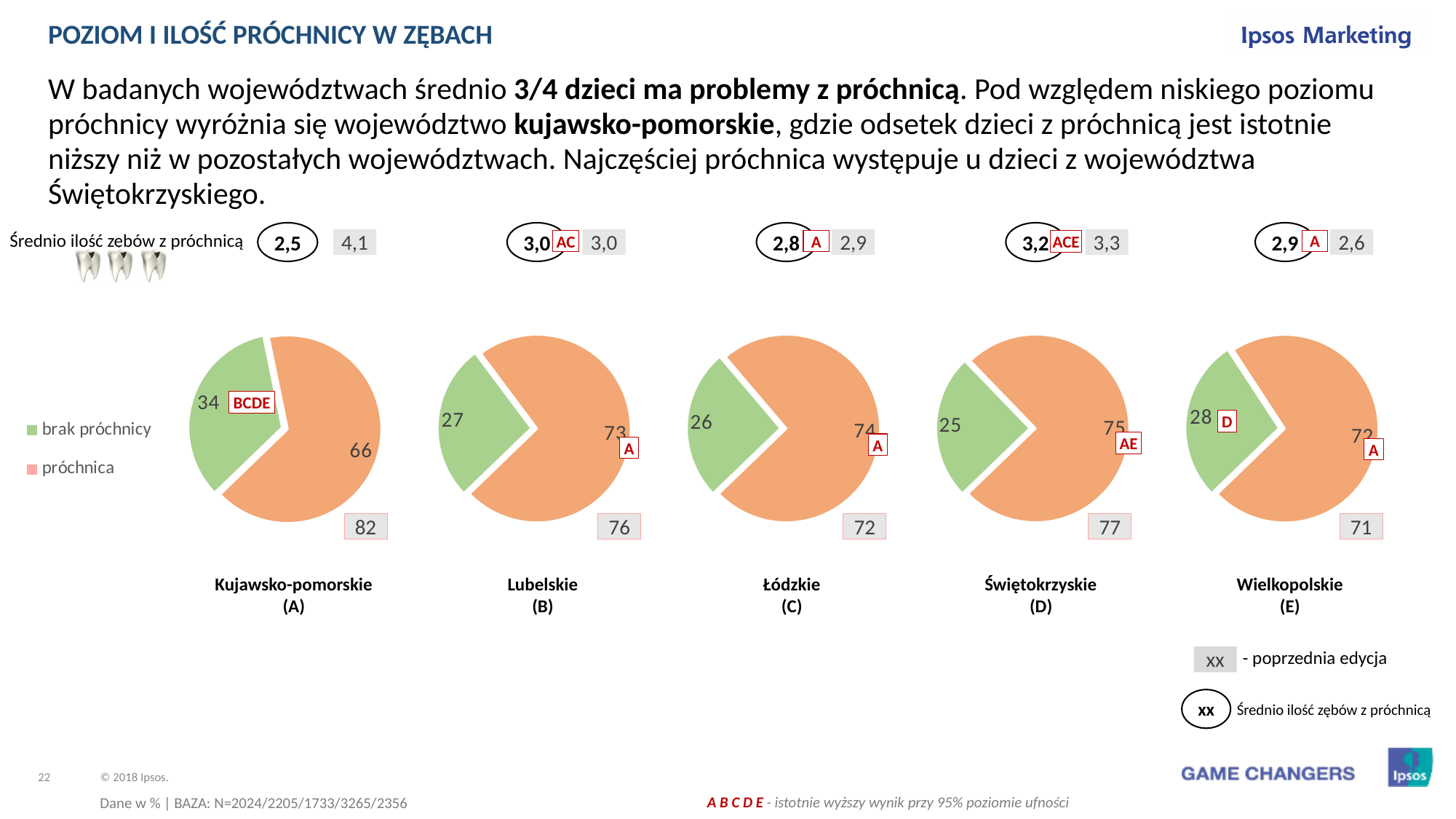
What type of chart is used to show the share of children with próchnica in each voivodeship? Pie chart In the Lubelskie (B) pie chart, what is the value for brak próchnicy? 27 In the Wielkopolskie (E) pie chart, what is the value for brak próchnicy? 28 Across the five pie charts, which voivodeship has the lowest value for próchnica? Kujawsko-pomorskie (A) In the Łódzkie (C) pie chart, what is the difference between the próchnica and brak próchnicy values? 48 How many series does the legend list for the pie charts? 2 How many pie charts are shown on the slide? 5 Which is larger: the brak próchnicy value in the Kujawsko-pomorskie (A) chart or in the Wielkopolskie (E) chart? Kujawsko-pomorskie (A) In the Lubelskie (B) chart, what was the próchnica value in the previous edition (grey box)? 76 In the Świętokrzyskie (D) pie chart, what is the value for próchnica? 75 In the Kujawsko-pomorskie (A) pie chart, what is the value for próchnica? 66 Across the five pie charts, which voivodeship has the highest value for próchnica? Świętokrzyskie (D)